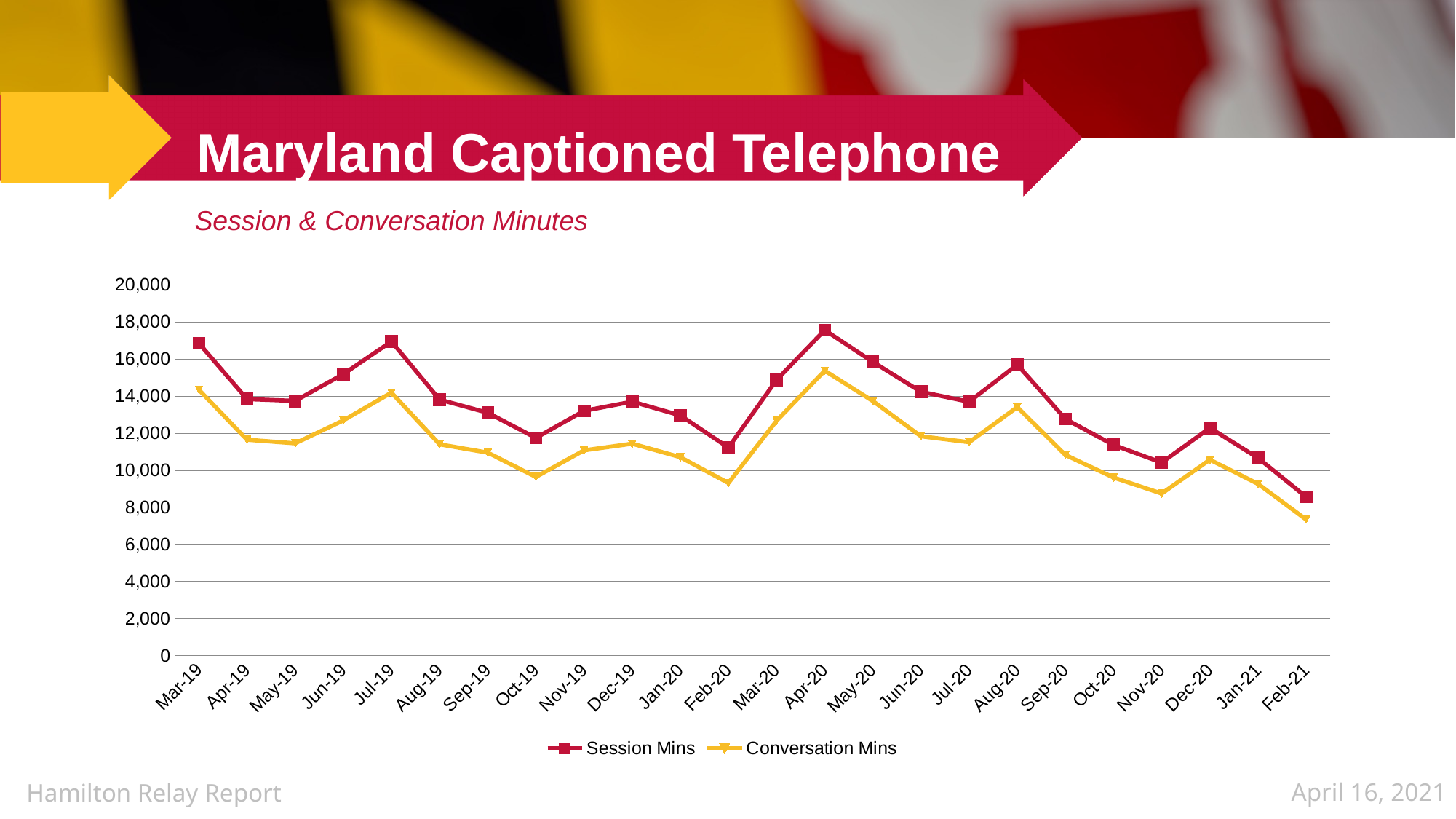
What kind of chart is shown on the slide? Line chart Which series has the higher values throughout the chart, Session Mins or Conversation Mins? Session Mins Is the Conversation Mins value for Apr-20 greater or less than 14,000? greater Which is larger, Session Mins in Apr-20 or Session Mins in Aug-20? Apr-20 In which month does Session Mins reach its highest value? Apr-20 How many series does the legend list? 2 Is the Session Mins value for Apr-20 greater or less than 16,000? greater Is the Session Mins value for Feb-20 greater or less than 12,000? less What is the subtitle shown above the chart? Session & Conversation Minutes In which month does Conversation Mins reach its lowest value? Feb-21 How many months are plotted along the x axis? 24